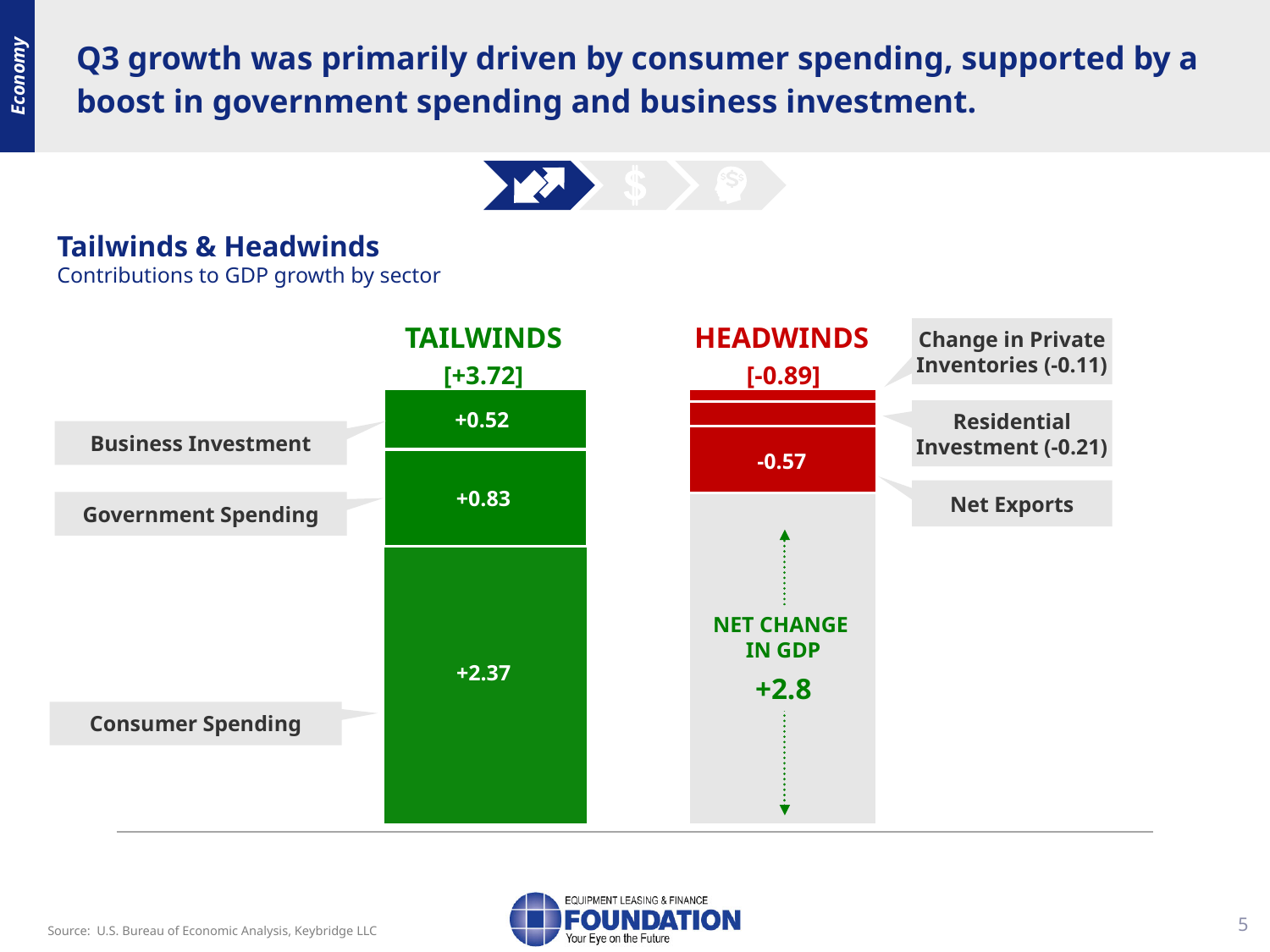
What is the value shown for Change in Private Inventories? -0.11 Which tailwind sector contributed the most to GDP growth? Consumer Spending What is the net change in GDP shown on the chart? +2.8 What is the value shown for Net Exports in the Headwinds bar? -0.57 Which headwind had the smallest negative contribution? Change in Private Inventories What is the total of the Tailwinds stacked bar? +3.72 What is the total of the Headwinds stacked bar? -0.89 What is the difference between the Government Spending and Business Investment contributions? 0.31 What is the value shown for Residential Investment in the Headwinds bar? -0.21 What is the contribution of Consumer Spending to GDP growth shown in the Tailwinds bar? +2.37 What is the contribution of Government Spending shown in the Tailwinds bar? +0.83 What is the contribution of Business Investment shown in the Tailwinds bar? +0.52